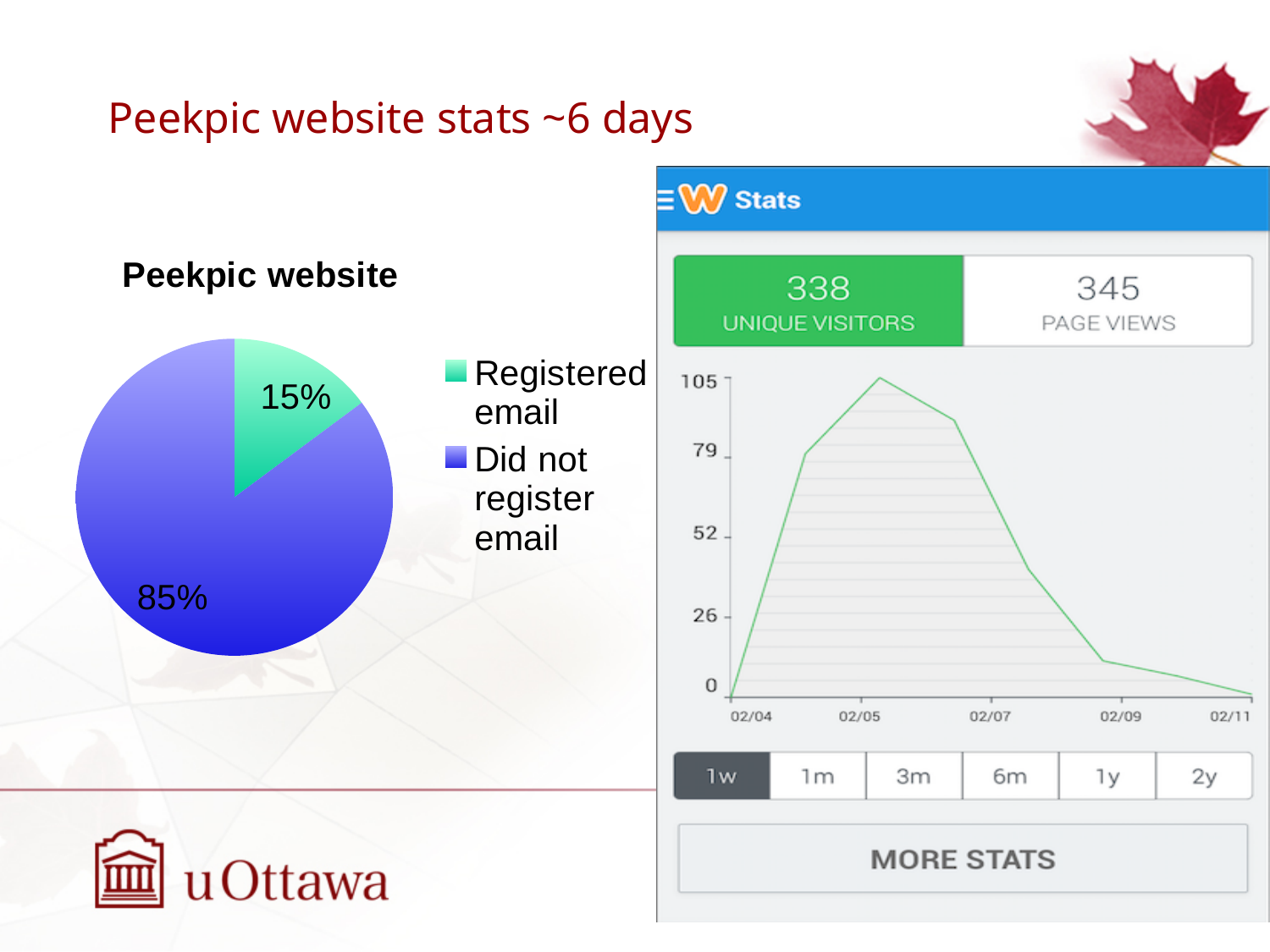
In the Peekpic website pie chart, what percentage of users registered an email? 15% What type of chart is shown in the Stats screenshot on the right of the slide? Line chart In the Stats line chart on the right, is the value at 02/09 greater or less than 26? less In the Stats line chart on the right, is the peak value greater or less than 79? greater In the Peekpic website pie chart, what percentage of users did not register an email? 85% In the Peekpic website pie chart, which category has the smallest share? Registered email In the Peekpic website pie chart, what is the difference in percentage points between the 'Did not register email' and 'Registered email' slices? 70 How many categories does the Peekpic website pie chart show? 2 What type of chart is the Peekpic website chart on the left of the slide? Pie chart In the Peekpic website pie chart, which category has the largest share? Did not register email In the Peekpic website pie chart, which colour represents 'Registered email'? Green In the Stats line chart on the right, do the values rise or fall between 02/07 and 02/11? fall